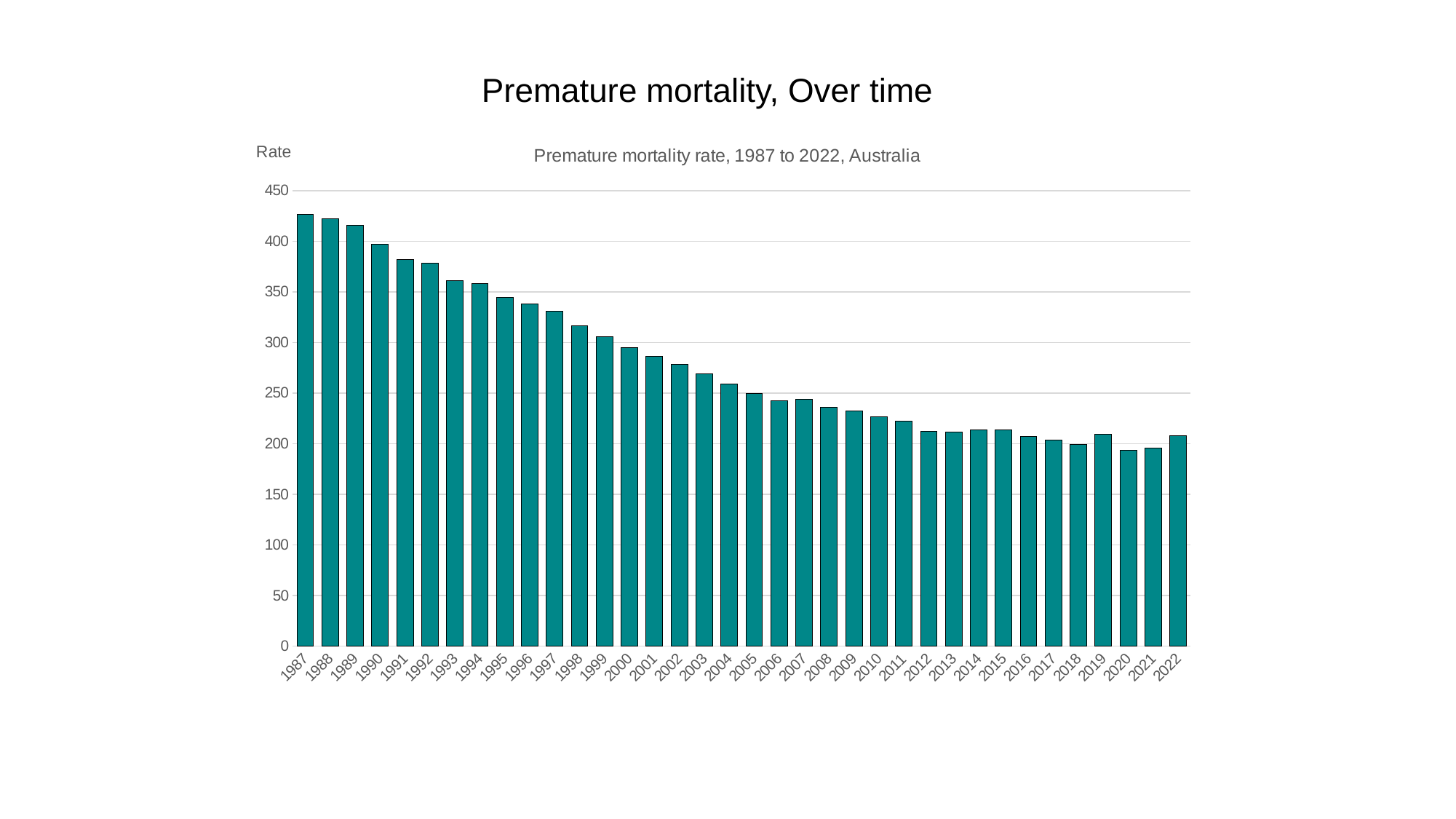
Which is larger, the value for 1987 or the value for 2022? 1987 How many years are plotted on the chart? 36 Is the value for 1987 greater or less than 400? greater What is the subtitle shown above the chart? Premature mortality rate, 1987 to 2022, Australia Which year has the highest premature mortality rate? 1987 Which is larger, the value for 1995 or the value for 2005? 1995 Do the values generally rise or fall from 1987 to 2022? fall Is the value for 1993 greater or less than 350? greater Is the value for 2003 greater or less than 300? less What kind of chart is shown on the slide? bar chart